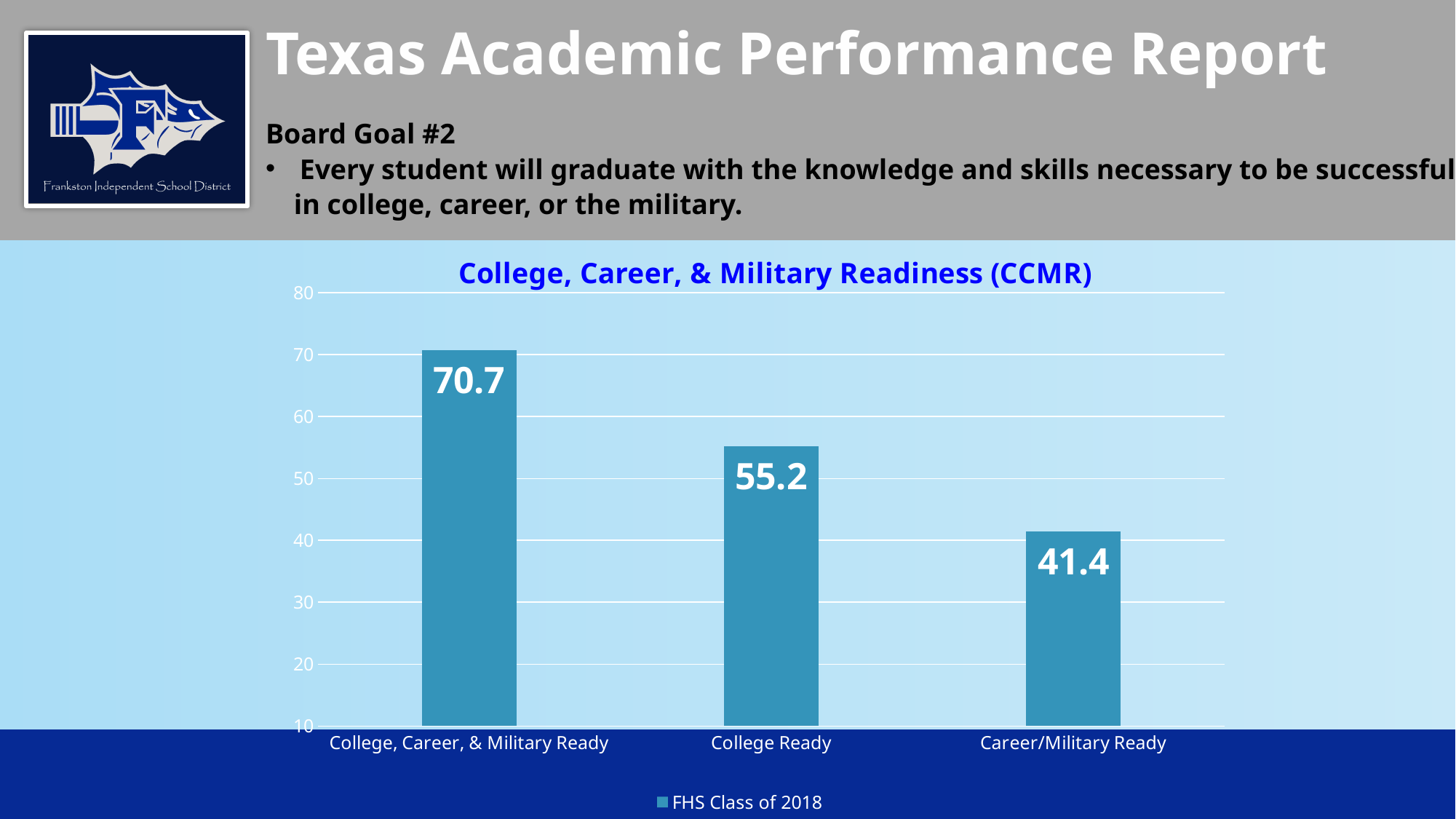
What is the value for Career/Military Ready? 41.4 What series does the legend list? FHS Class of 2018 Which is larger, the value for College Ready or the value for Career/Military Ready? College Ready What is the difference between the values for College Ready and Career/Military Ready? 13.8 What is the value for College, Career, & Military Ready? 70.7 What is the difference between the values for College, Career, & Military Ready and College Ready? 15.5 What is the value for College Ready? 55.2 Which category has the lowest value? Career/Military Ready What kind of chart is shown on the slide? bar chart How many categories are shown in the chart? 3 Is the value for Career/Military Ready greater or less than 50? less Which category has the highest value? College, Career, & Military Ready